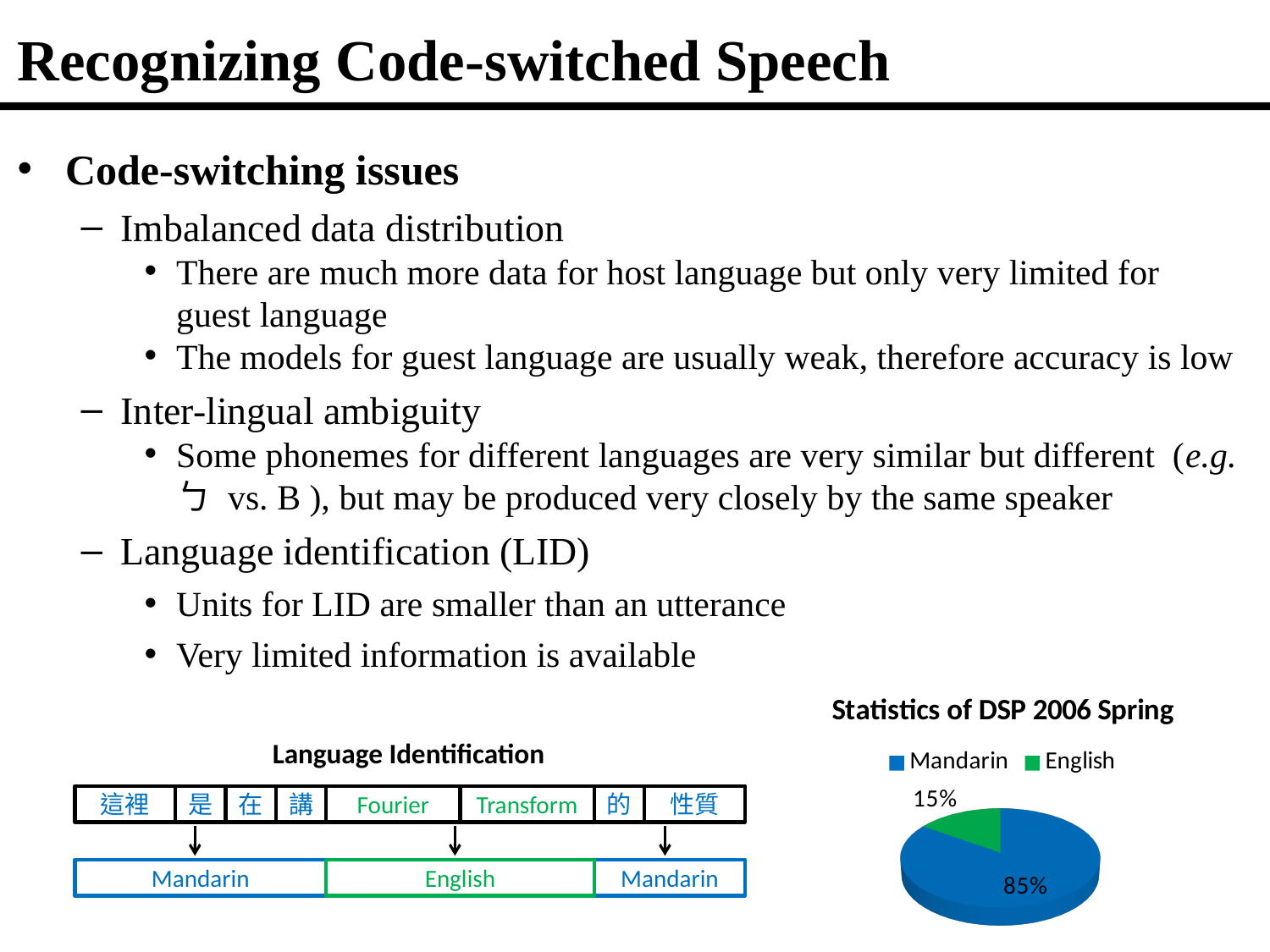
In the "Statistics of DSP 2006 Spring" pie chart, which is larger, the Mandarin slice or the English slice? Mandarin How many slices does the "Statistics of DSP 2006 Spring" pie chart have? 2 In the "Statistics of DSP 2006 Spring" pie chart, what colour is the English slice? green What is the title of the pie chart on the slide? Statistics of DSP 2006 Spring In the "Statistics of DSP 2006 Spring" pie chart, which language has the largest slice? Mandarin What kind of chart is shown under the title "Statistics of DSP 2006 Spring"? pie chart In the "Statistics of DSP 2006 Spring" pie chart, what share is labelled for Mandarin? 85% In the "Statistics of DSP 2006 Spring" pie chart, what share is labelled for English? 15% In the "Statistics of DSP 2006 Spring" pie chart, which language has the smallest slice? English How many entries does the legend of the "Statistics of DSP 2006 Spring" pie chart list? 2 In the "Statistics of DSP 2006 Spring" pie chart, what is the difference between the Mandarin and English shares? 70%